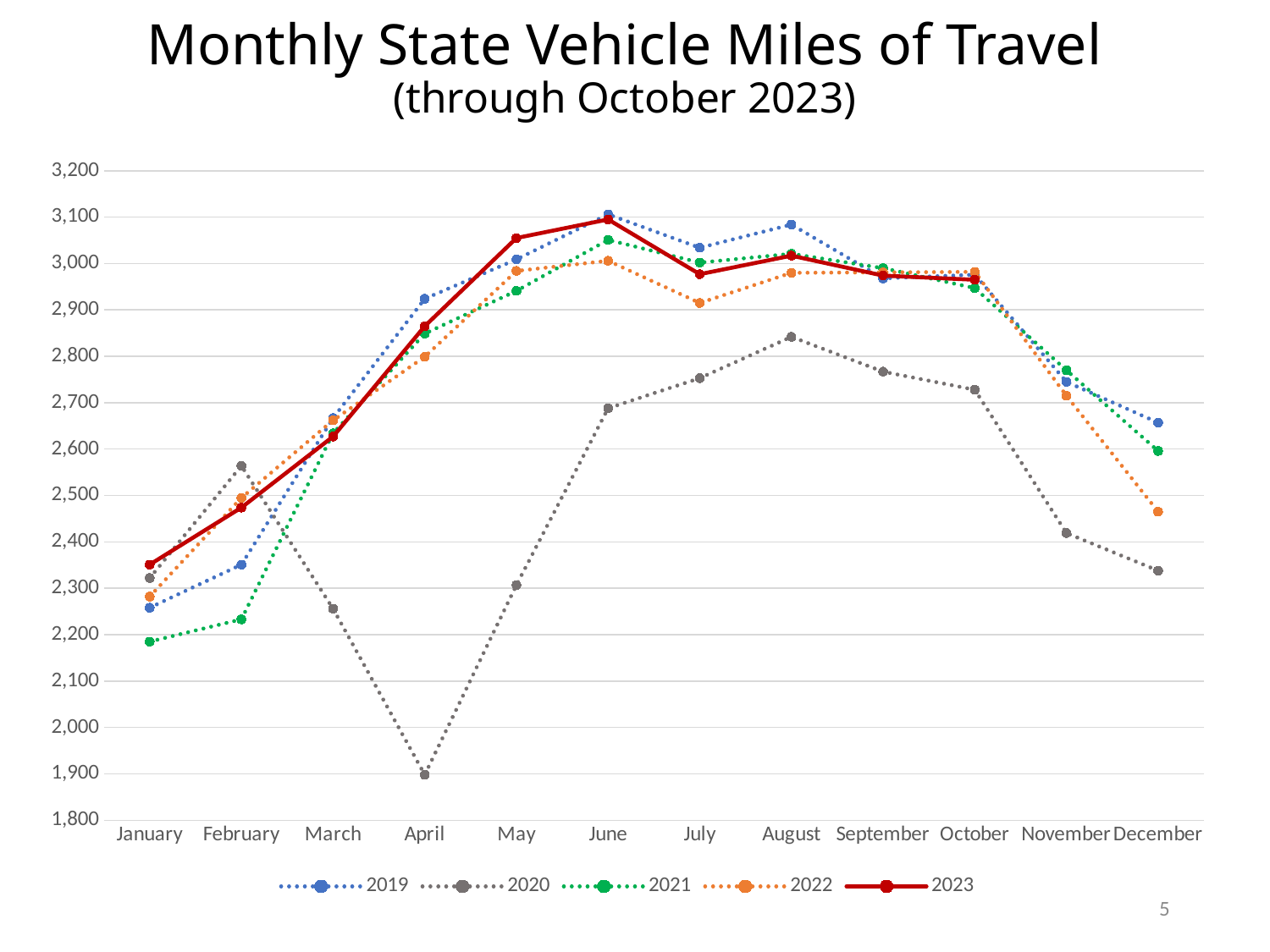
What kind of chart is shown on the slide? line chart Is the 2020 value for December greater or less than 2,400? less Does the 2023 series rise or fall from January to June? rise In which month does the 2020 series reach its highest value? August Is the 2023 value for May greater or less than 3,000? greater How many series does the legend list? 5 Is the 2020 value for April greater or less than 2,000? less Which series is drawn as a solid line rather than a dotted line? 2023 Which series has the lowest value in April? 2020 How many months are shown along the x axis? 12 In which month does the 2020 series reach its lowest value? April Which is larger in February, the 2020 value or the 2019 value? 2020